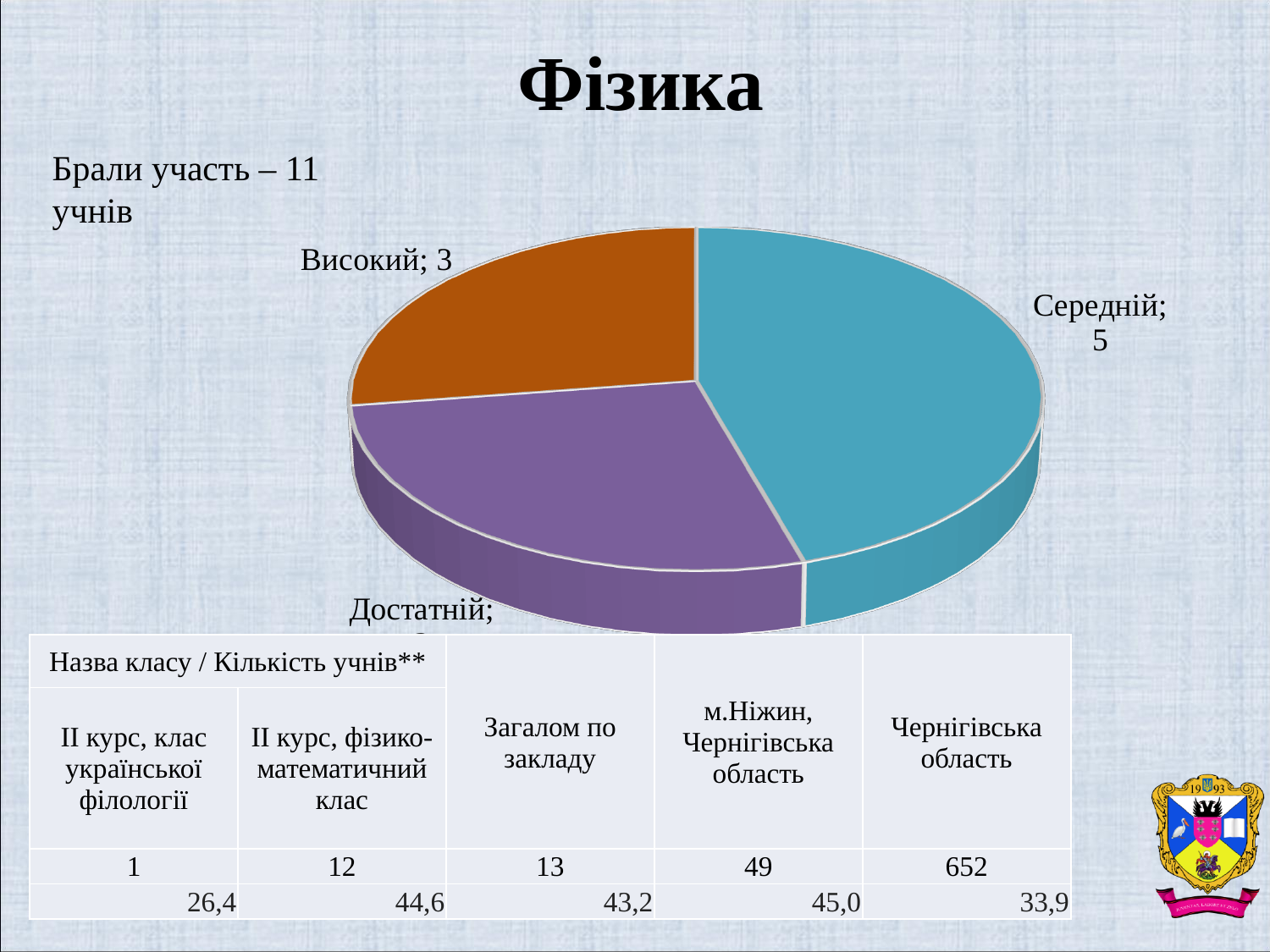
What is the value for the Середній slice? 5 What is the value for the Високий slice? 3 How many slices does the pie chart have? 3 Which slice of the pie chart is the largest? Середній How many students took part according to the text next to the chart? 11 Which is larger, the Середній slice or the Високий slice? Середній What kind of chart is shown on the slide? pie chart Which slice is coloured orange-brown? Високий What is the difference between the Середній value and the Високий value? 2 What is the title of the slide with the pie chart? Фізика